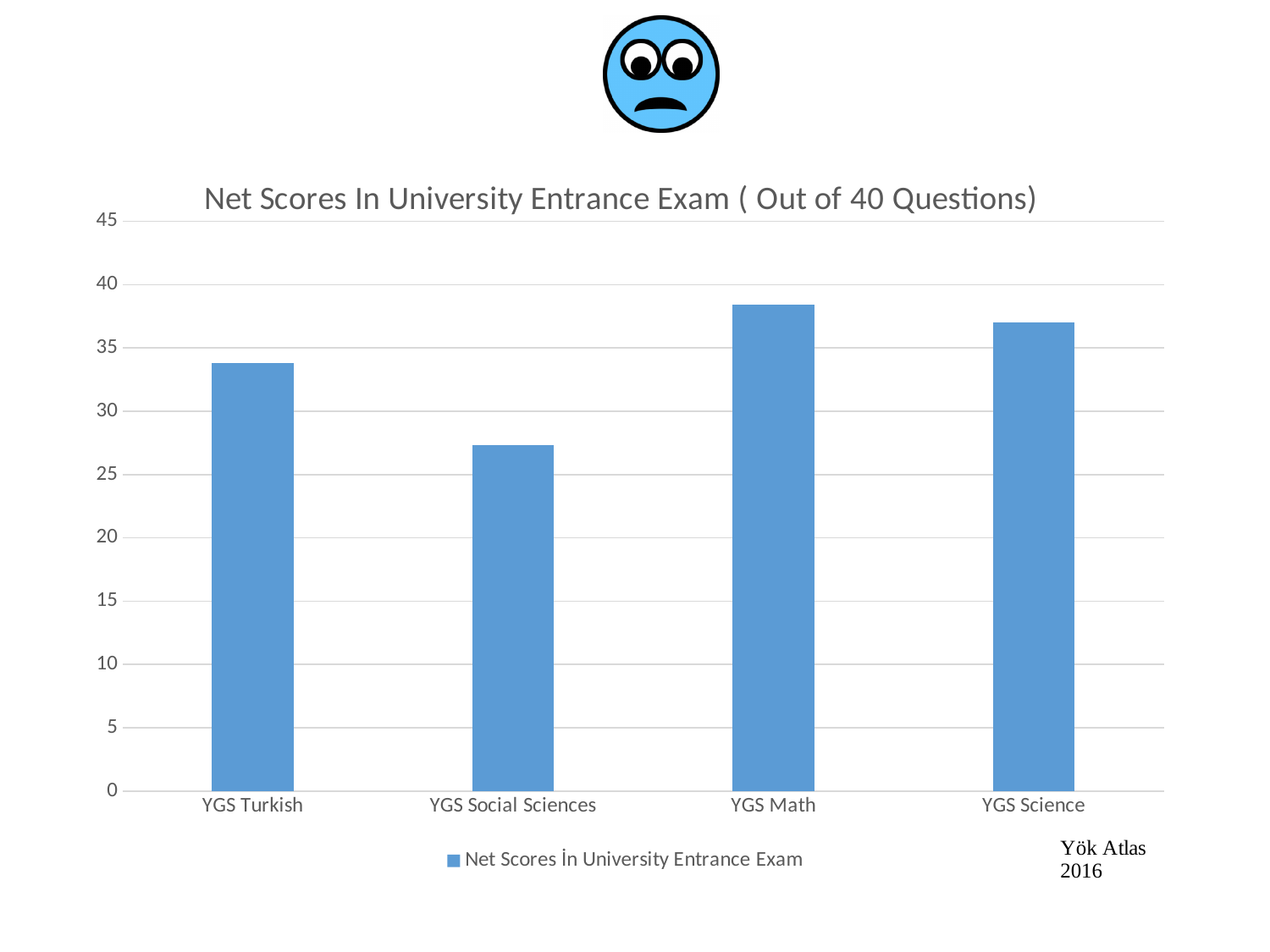
What is the title of the chart? Net Scores In University Entrance Exam ( Out of 40 Questions) How many categories are shown on the x axis of the chart? 4 Is the value for YGS Math greater or less than 40? less Is the value for YGS Turkish greater or less than 30? greater Which category has the lowest net score? YGS Social Sciences Which is larger, the value for YGS Turkish or the value for YGS Social Sciences? YGS Turkish What is the legend entry for the series in the chart? Net Scores İn University Entrance Exam What type of chart is shown on the slide? bar chart Is the value for YGS Science greater or less than 35? greater How many series does the legend list? 1 Which category has the highest net score? YGS Math